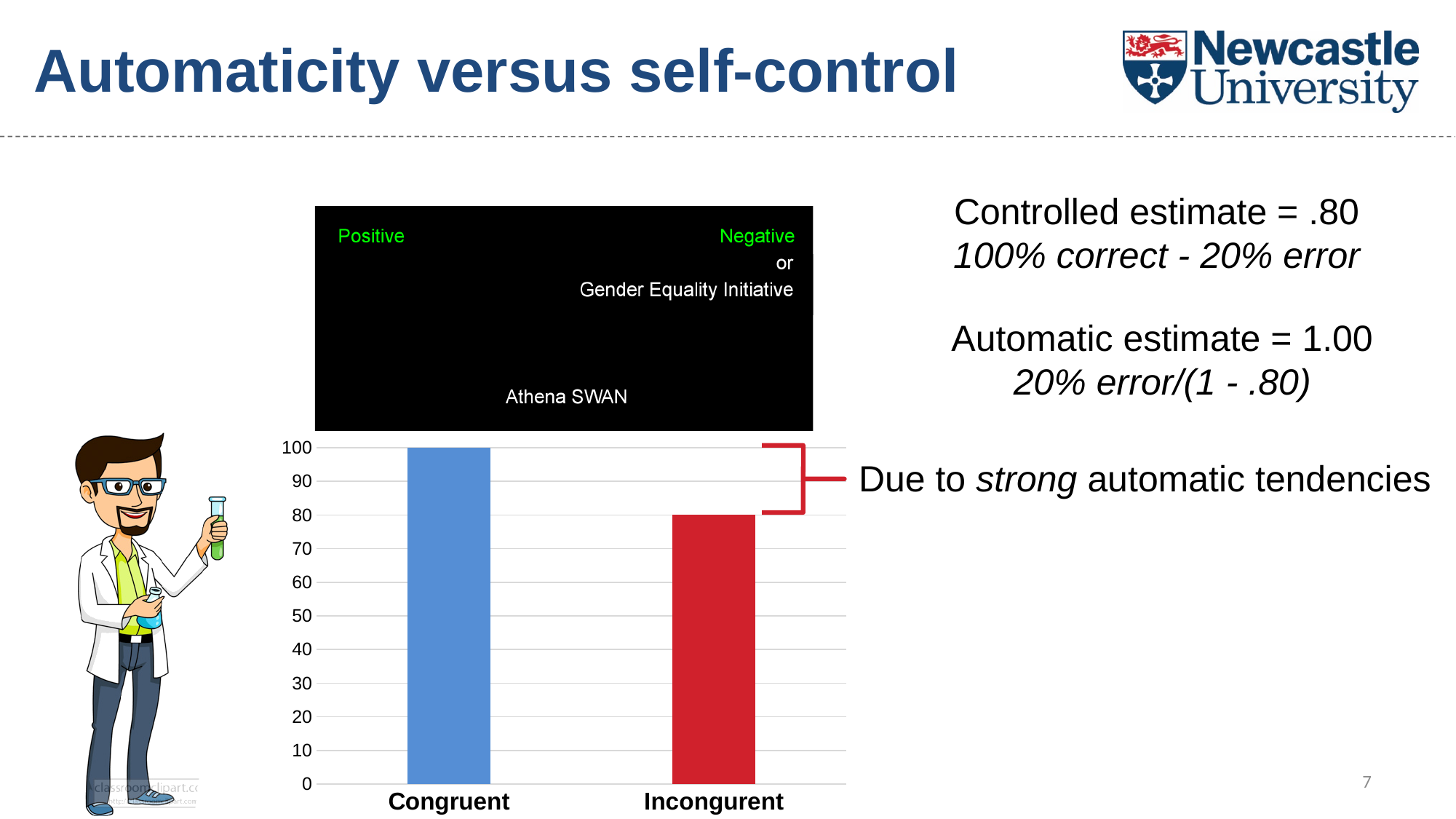
Is the value for Incongurent greater or less than 90? less What kind of chart is shown on the slide? bar chart Do the bar values rise or fall from Congruent to Incongurent? fall Which category has the highest bar? Congruent Which category has the lowest bar? Incongurent What is the value of the Congruent bar? 100 What colour is the Incongurent bar? red What is the highest tick value shown on the y axis of the bar chart? 100 What is the value of the Incongurent bar? 80 Which is larger, the Congruent bar or the Incongurent bar? Congruent How many categories are shown on the x axis of the bar chart? 2 What is the difference between the Congruent and Incongurent bars? 20